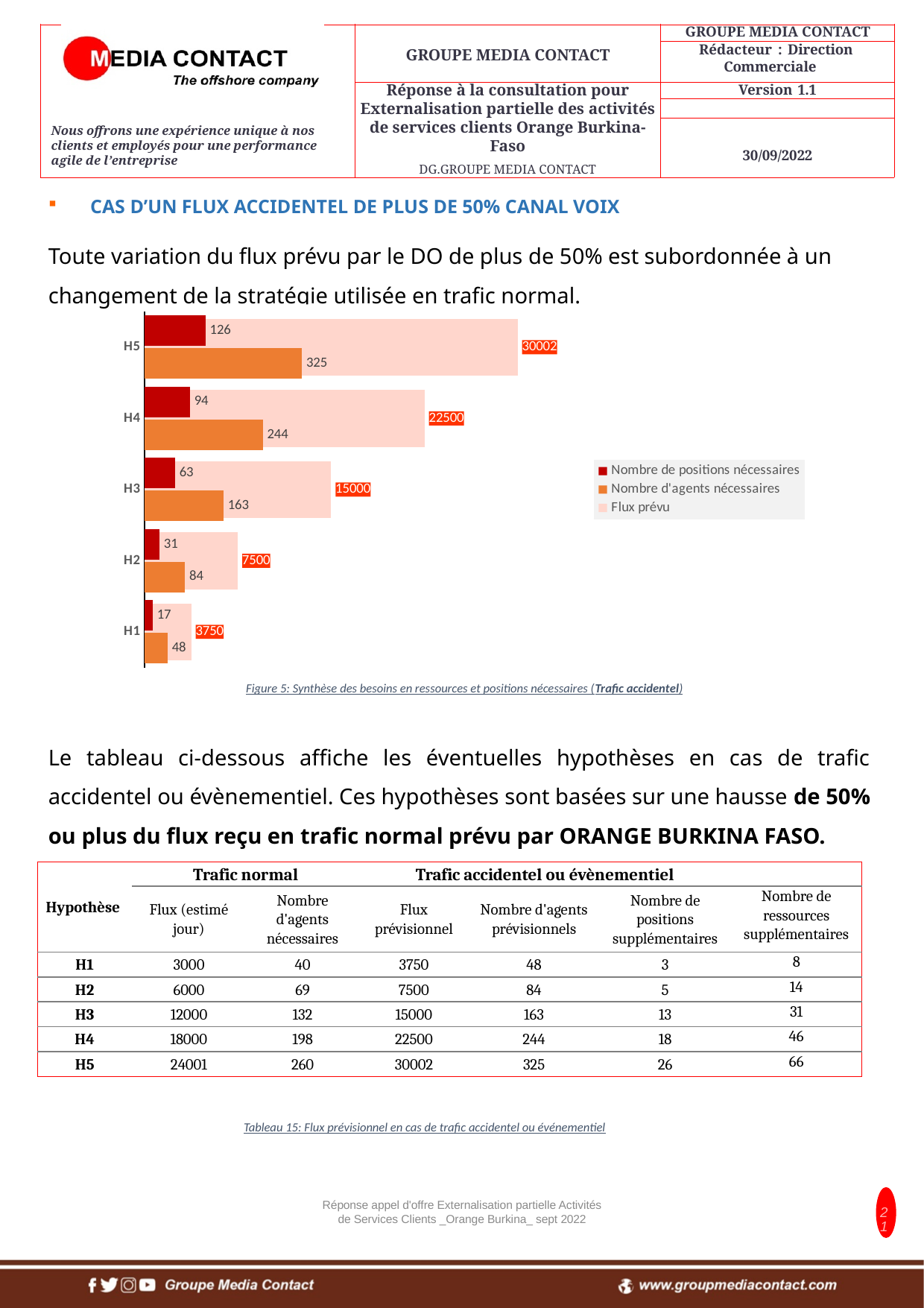
How many categories (hypotheses) are plotted on the chart? 5 What kind of chart is shown on the slide? bar chart What is the value of Flux prévu for H5? 30002 Which series is shown in dark red in the chart legend? Nombre de positions nécessaires Which category has the lowest Nombre d'agents nécessaires? H1 Do the Flux prévu values rise or fall from H1 to H5? rise What is the value of Nombre d'agents nécessaires for H3? 163 What is the difference between Nombre d'agents nécessaires for H5 and for H4? 81 What is the value of Nombre de positions nécessaires for H2? 31 How many series does the chart legend list? 3 Which is larger: Nombre de positions nécessaires for H4 or Nombre d'agents nécessaires for H2? Nombre de positions nécessaires for H4 Which category has the highest Flux prévu? H5